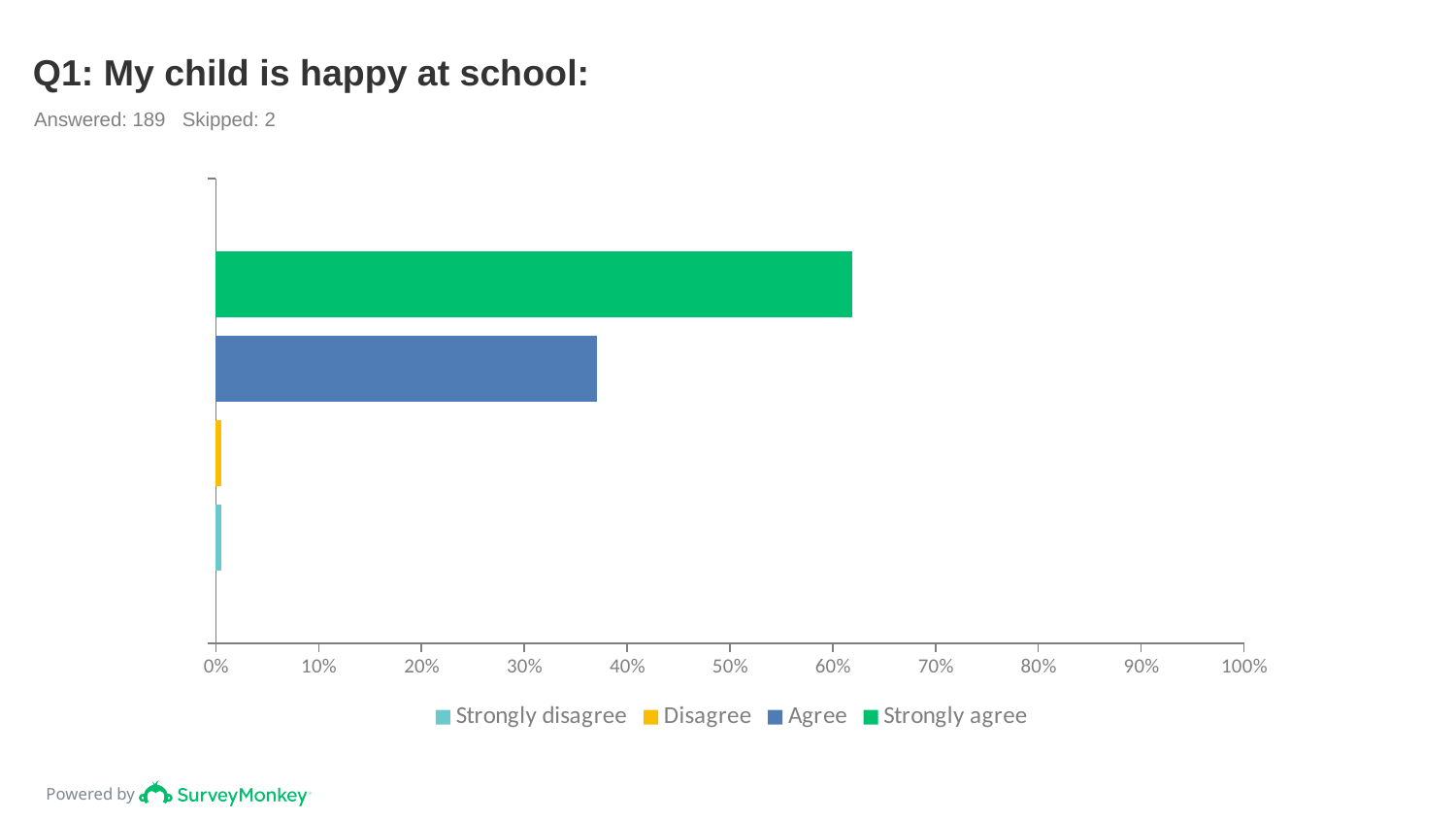
Is the value for Strongly agree greater or less than 60%? greater Is the value for Agree greater or less than 40%? less How many respondents answered the question according to the slide? 189 Which response has the highest value? Strongly agree Which is larger, the value for Agree or the value for Strongly agree? Strongly agree Is the value for Strongly agree greater or less than 70%? less What kind of chart is shown on the slide? bar chart How many series does the legend list? 4 What is the title of the chart? Q1: My child is happy at school: